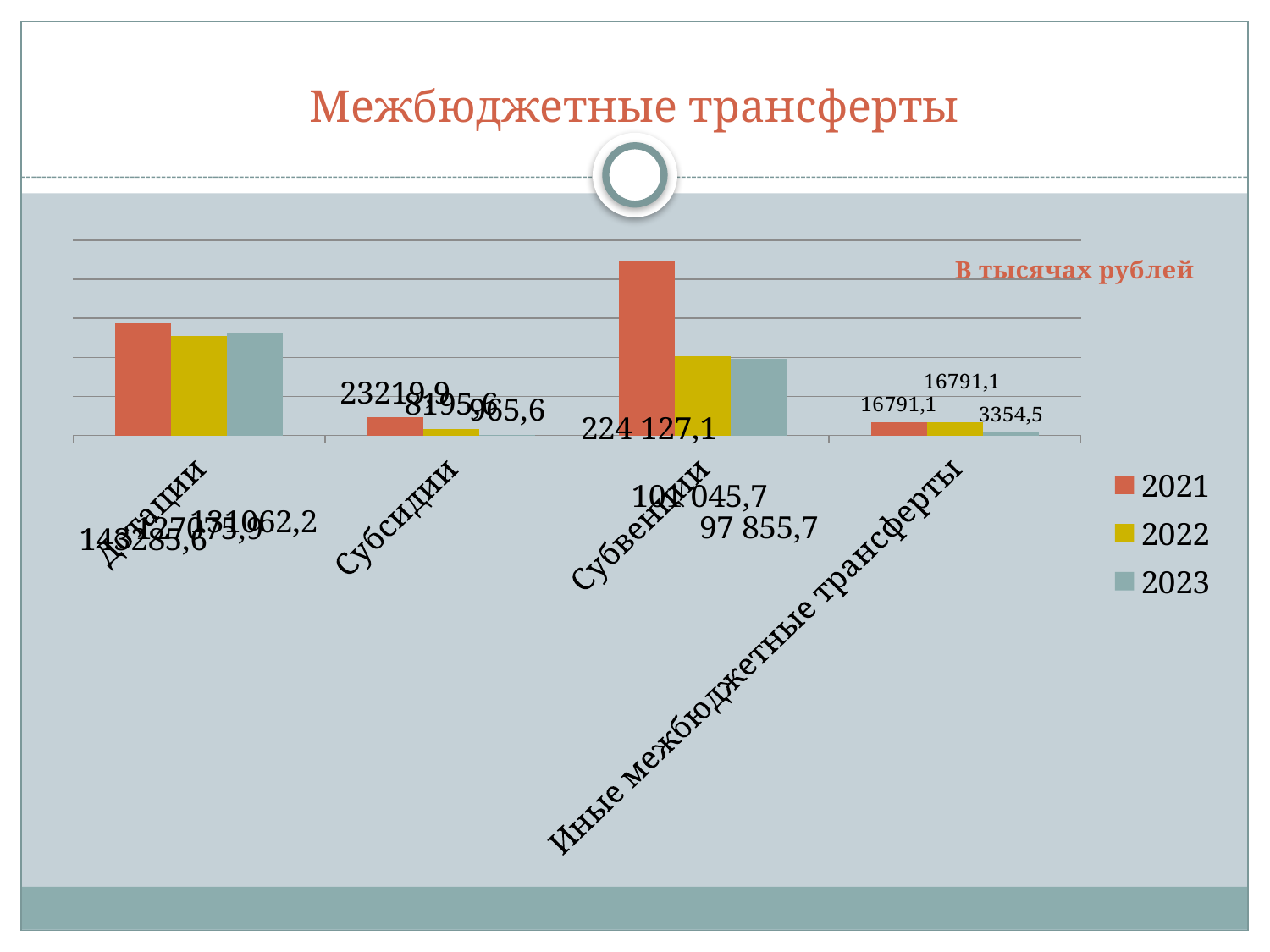
What is the value for Субвенции in 2023? 97 855,7 What is the value for Субсидии in 2021? 23219,9 What is the value for Иные межбюджетные трансферты in 2023? 3354,5 What kind of chart is shown on the slide? bar chart Which category has the highest bar in the chart? Субвенции What is the difference between the 2021 and 2022 values for Субвенции? 123 081,4 What is the value for Субвенции in 2021? 224 127,1 Which is larger for Субвенции: the 2022 value or the 2023 value? 2022 What is the value for Субвенции in 2022? 101 045,7 How many categories are shown on the x axis? 4 What unit is stated on the chart? В тысячах рублей How many series does the legend list? 3